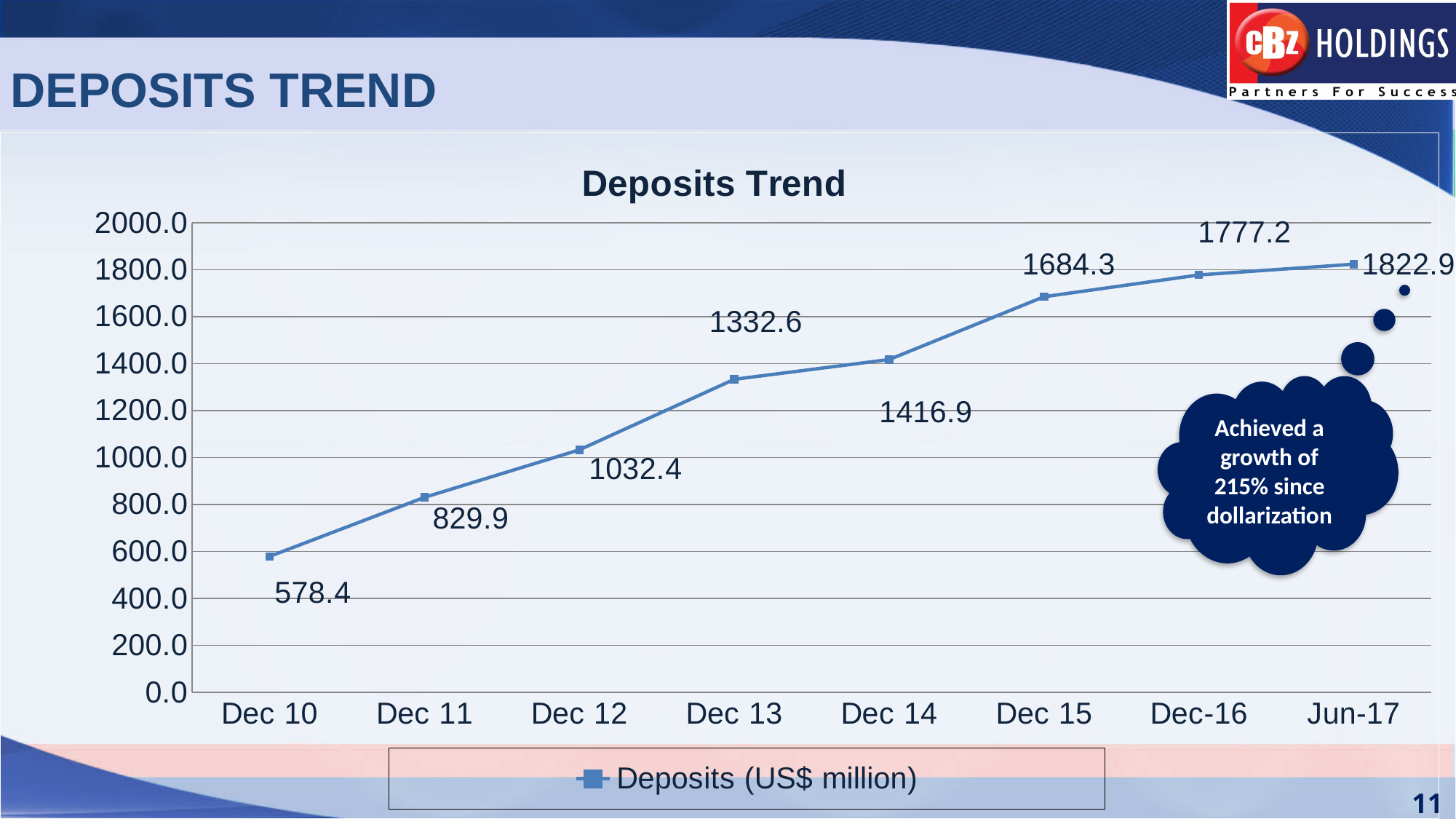
Do the deposits values rise or fall from Dec 10 to Jun-17? Rise How many data points are plotted on the chart? 8 Is the value for Dec-16 greater or less than 1600.0? greater Which is larger, the deposits value for Dec 12 or Dec 11? Dec 12 How many series does the legend list? 1 What is the value of Deposits (US$ million) for Dec 13? 1332.6 What is the value of Deposits (US$ million) for Dec 10? 578.4 What is the value of Deposits (US$ million) for Jun-17? 1822.9 What kind of chart is shown on the slide? Line chart Which period has the lowest deposits value? Dec 10 What is the difference between the deposits values for Dec 15 and Dec 14? 267.4 Which period has the highest deposits value? Jun-17